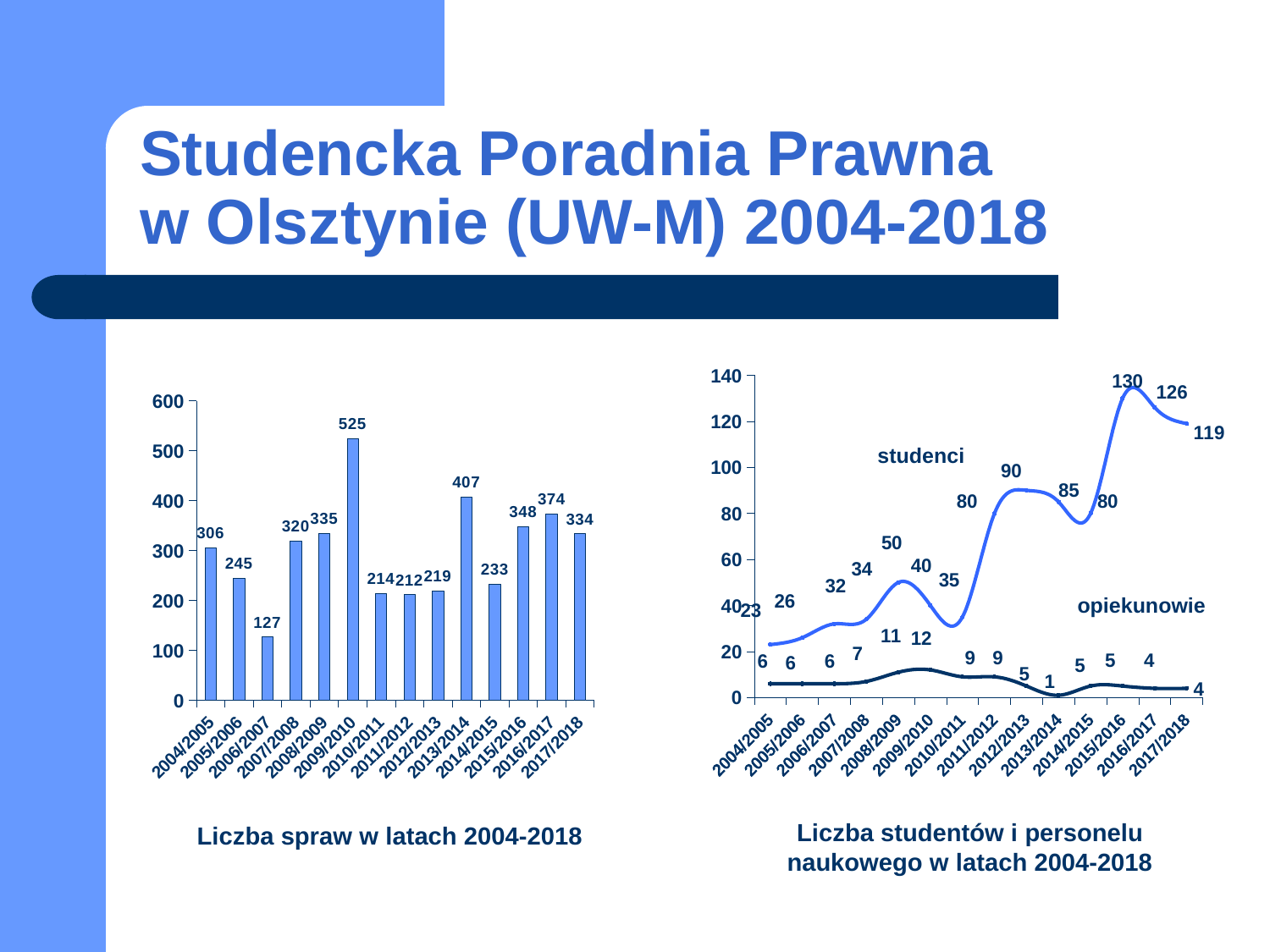
What kind of chart is 'Liczba spraw w latach 2004-2018'? Bar chart In the chart 'Liczba studentów i personelu naukowego w latach 2004-2018', what is the value for opiekunowie in 2013/2014? 1 In the chart 'Liczba spraw w latach 2004-2018', which year has the lowest value? 2006/2007 In the chart 'Liczba spraw w latach 2004-2018', what is the value for 2009/2010? 525 In the chart 'Liczba studentów i personelu naukowego w latach 2004-2018', which year has the highest value for opiekunowie? 2009/2010 In the chart 'Liczba spraw w latach 2004-2018', what is the difference between the values for 2013/2014 and 2014/2015? 174 In the chart 'Liczba studentów i personelu naukowego w latach 2004-2018', what is the difference between studenci and opiekunowie in 2017/2018? 115 In the chart 'Liczba studentów i personelu naukowego w latach 2004-2018', which is larger: studenci in 2011/2012 or studenci in 2012/2013? 2012/2013 In the chart 'Liczba studentów i personelu naukowego w latach 2004-2018', what is the value for studenci in 2015/2016? 130 In the chart 'Liczba spraw w latach 2004-2018', which year has the highest value? 2009/2010 What kind of chart is 'Liczba studentów i personelu naukowego w latach 2004-2018'? Line chart In the chart 'Liczba spraw w latach 2004-2018', how many bars are plotted? 14